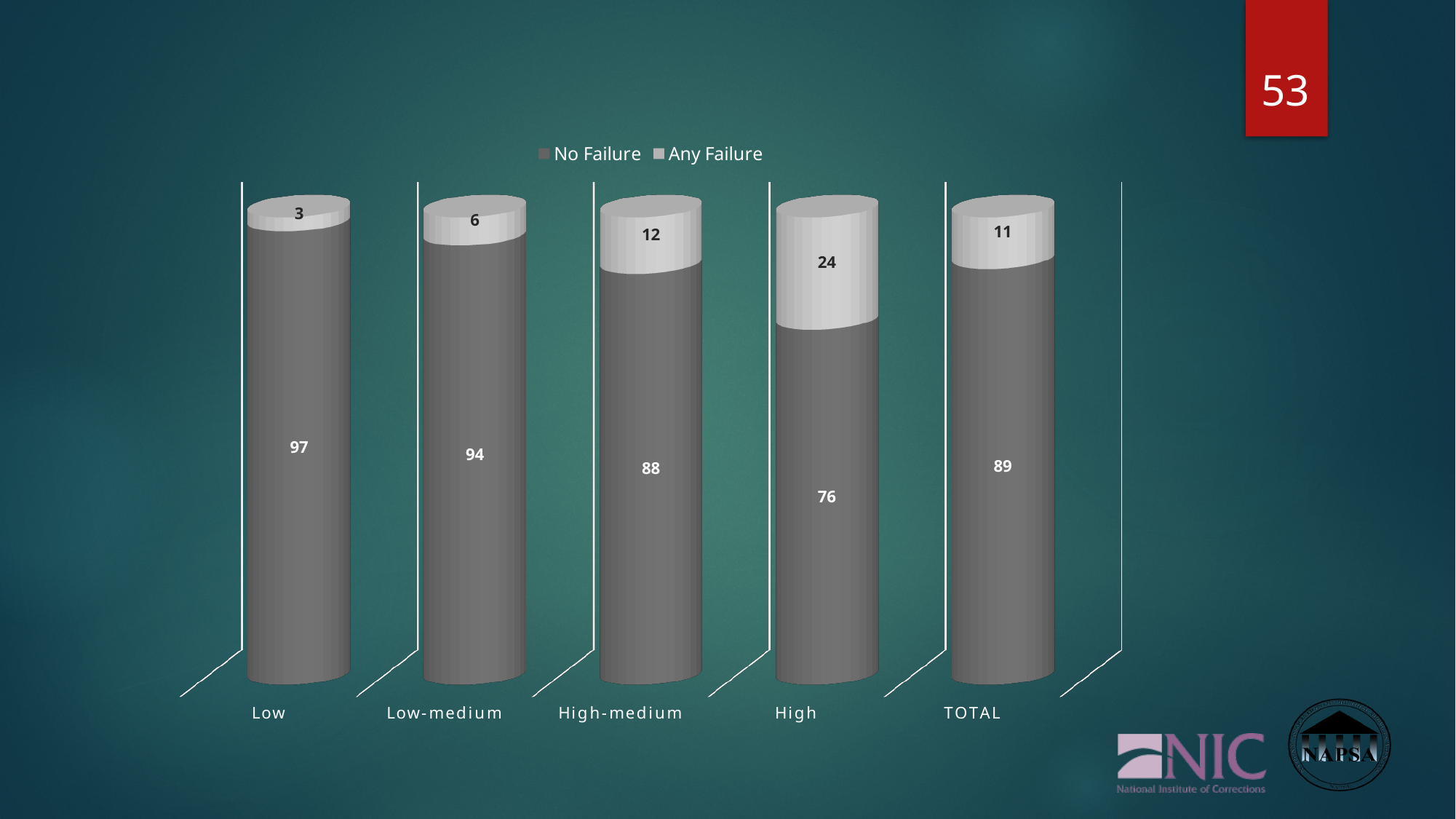
How many series does the legend list? 2 What is the total of the stacked bar for High-medium? 100 What is the Any Failure value for the High category? 24 How many categories are shown on the x axis? 5 What is the Any Failure value for High-medium? 12 Which category has the lowest No Failure value? High Which category has the highest Any Failure value? High What is the difference between the No Failure values for Low and High? 21 What kind of chart is shown on the slide? Stacked bar chart Which is larger, the Any Failure value for Low-medium or for TOTAL? TOTAL What is the No Failure value for the Low category? 97 What is the No Failure value for TOTAL? 89